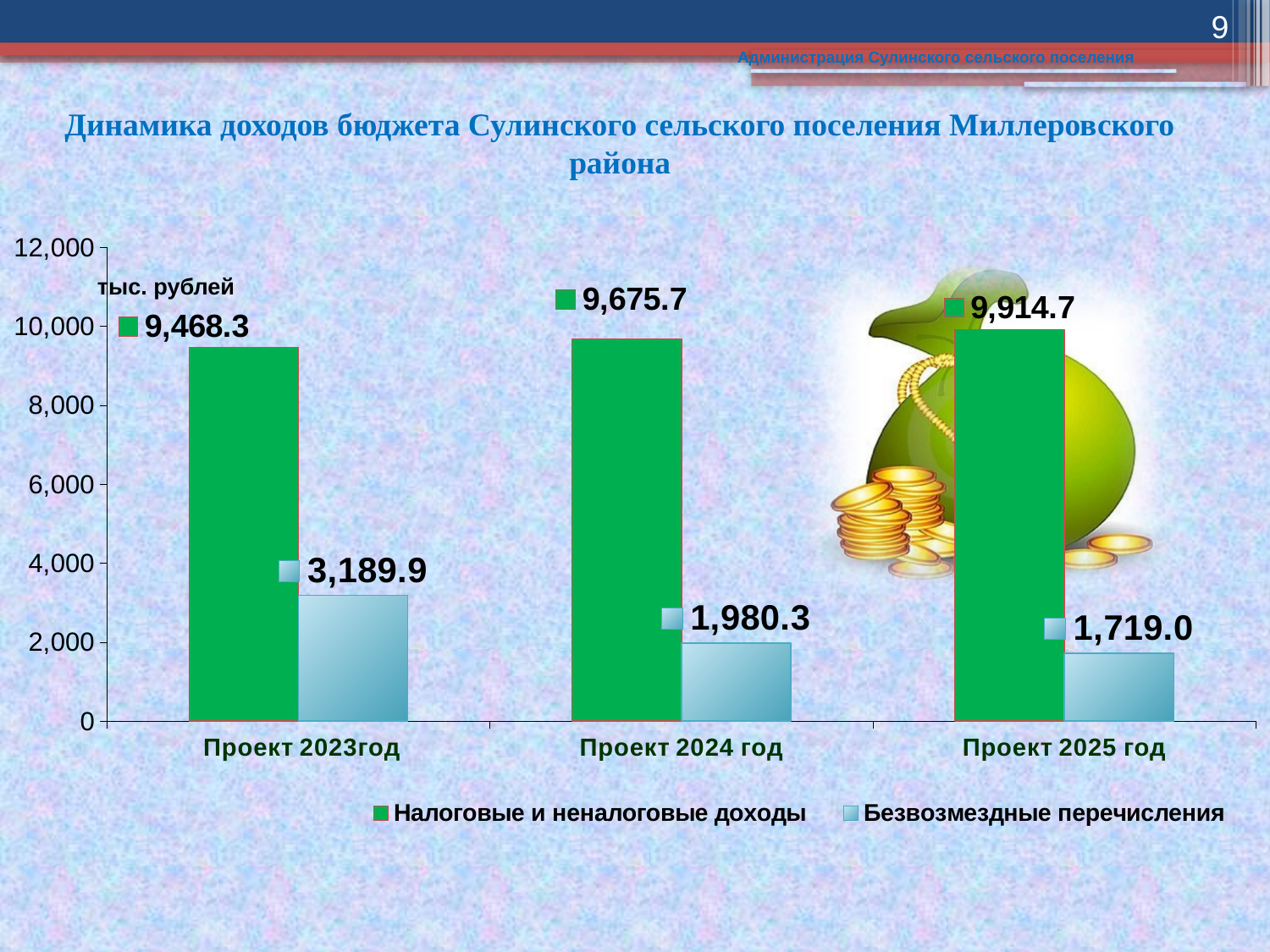
What is the value of Налоговые и неналоговые доходы for Проект 2024 год? 9,675.7 What is the difference between Налоговые и неналоговые доходы for Проект 2025 год and Проект 2023год? 446.4 Is the value of Налоговые и неналоговые доходы for Проект 2023год greater or less than 8,000? greater Do the values of Налоговые и неналоговые доходы rise or fall from Проект 2023год to Проект 2025 год? rise How many series does the legend list? 2 What is the value of Безвозмездные перечисления for Проект 2023год? 3,189.9 In which year is Безвозмездные перечисления lowest? Проект 2025 год In which year is Налоговые и неналоговые доходы highest? Проект 2025 год How many categories (years) are shown on the x axis? 3 What is the difference between Безвозмездные перечисления for Проект 2023год and Проект 2025 год? 1,470.9 What is the value of Безвозмездные перечисления for Проект 2025 год? 1,719.0 Which is larger: Безвозмездные перечисления for Проект 2024 год or for Проект 2025 год? Проект 2024 год